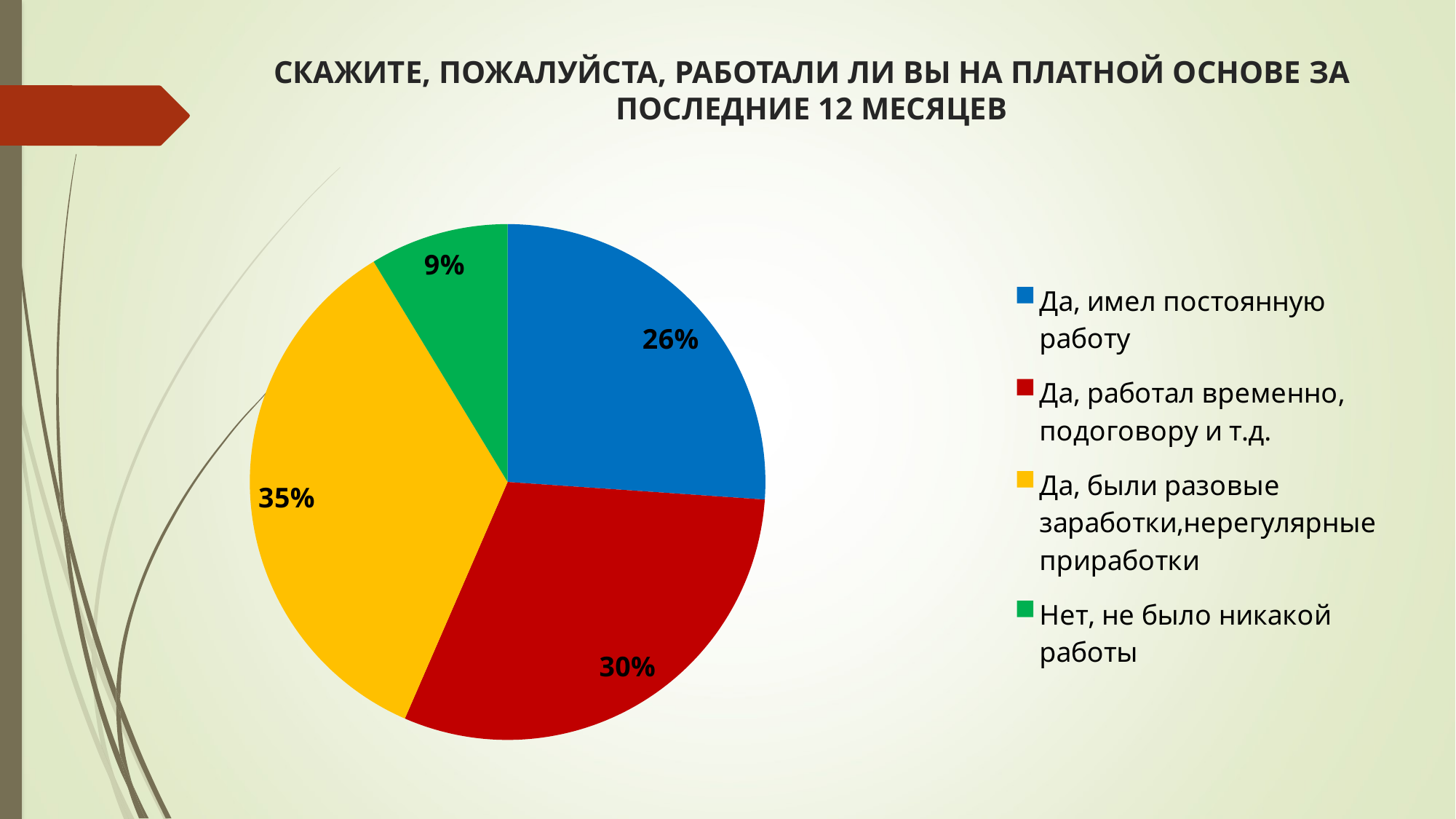
What share of respondents answered "Нет, не было никакой работы"? 9% What share of respondents answered "Да, были разовые заработки,нерегулярные приработки"? 35% What colour is the slice for "Нет, не было никакой работы"? green Which is larger: the share for "Да, работал временно, подоговору и т.д." or the share for "Да, имел постоянную работу"? Да, работал временно, подоговору и т.д. What share of respondents answered "Да, работал временно, подоговору и т.д."? 30% What type of chart is shown on the slide? pie chart What share of respondents answered "Да, имел постоянную работу"? 26% Which answer option has the largest share of the pie? Да, были разовые заработки,нерегулярные приработки What is the title of the chart? СКАЖИТЕ, ПОЖАЛУЙСТА, РАБОТАЛИ ЛИ ВЫ НА ПЛАТНОЙ ОСНОВЕ ЗА ПОСЛЕДНИЕ 12 МЕСЯЦЕВ How many slices does the pie chart have? 4 Which answer option has the smallest share of the pie? Нет, не было никакой работы What is the difference in percentage points between "Да, были разовые заработки,нерегулярные приработки" and "Да, имел постоянную работу"? 9